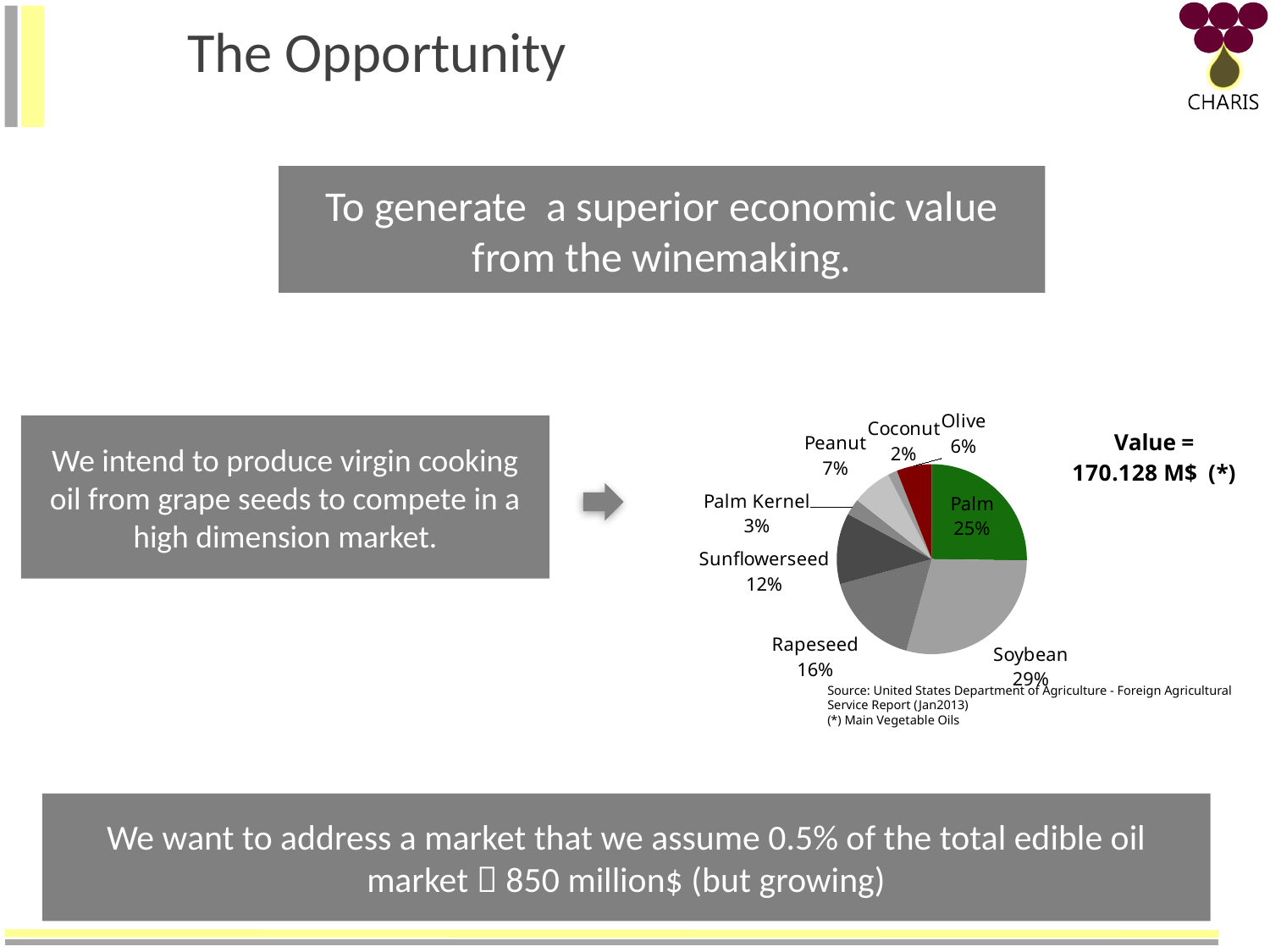
Which oil has the largest slice in the pie chart? Soybean What percentage does Sunflowerseed account for in the pie chart? 12% What is the difference in percentage points between Soybean and Palm in the pie chart? 4 Which is larger in the pie chart, Peanut or Olive? Peanut What is the value shown for Rapeseed in the pie chart? 16% Which oil has the smallest slice in the pie chart? Coconut How many slices does the pie chart have? 8 What is the combined share of Palm and Palm Kernel in the pie chart? 28% What percentage is shown for Palm in the pie chart? 25% What total value is stated next to the pie chart? 170.128 M$ What type of chart is shown on the slide? Pie chart What share of the pie chart does Soybean represent? 29%